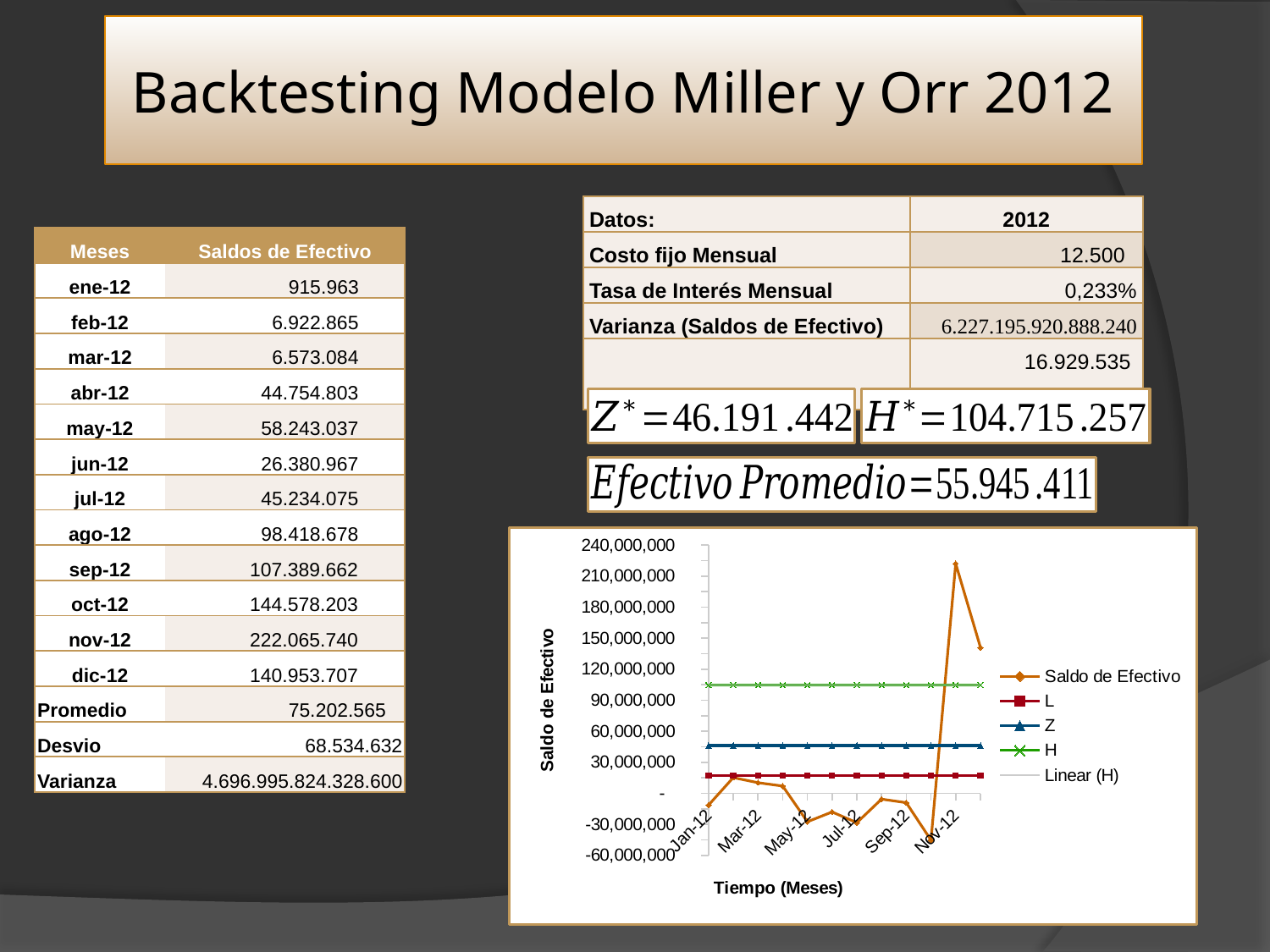
In which month does the Saldo de Efectivo series reach its highest value? Nov-12 What is the title of the chart's horizontal axis? Tiempo (Meses) How many series does the chart legend list? 5 What is the highest tick value shown on the chart's vertical axis? 240,000,000 Is the value of the L series greater or less than 30,000,000? less Is the value of the H series greater or less than 90,000,000? greater Which series is plotted higher on the chart, H or Z? H What kind of chart is shown on the slide? line chart Is the peak value of the Saldo de Efectivo series at Nov-12 greater or less than 180,000,000? greater Does the H series rise, fall, or stay flat across the months? stays flat What is the title of the chart's vertical axis? Saldo de Efectivo